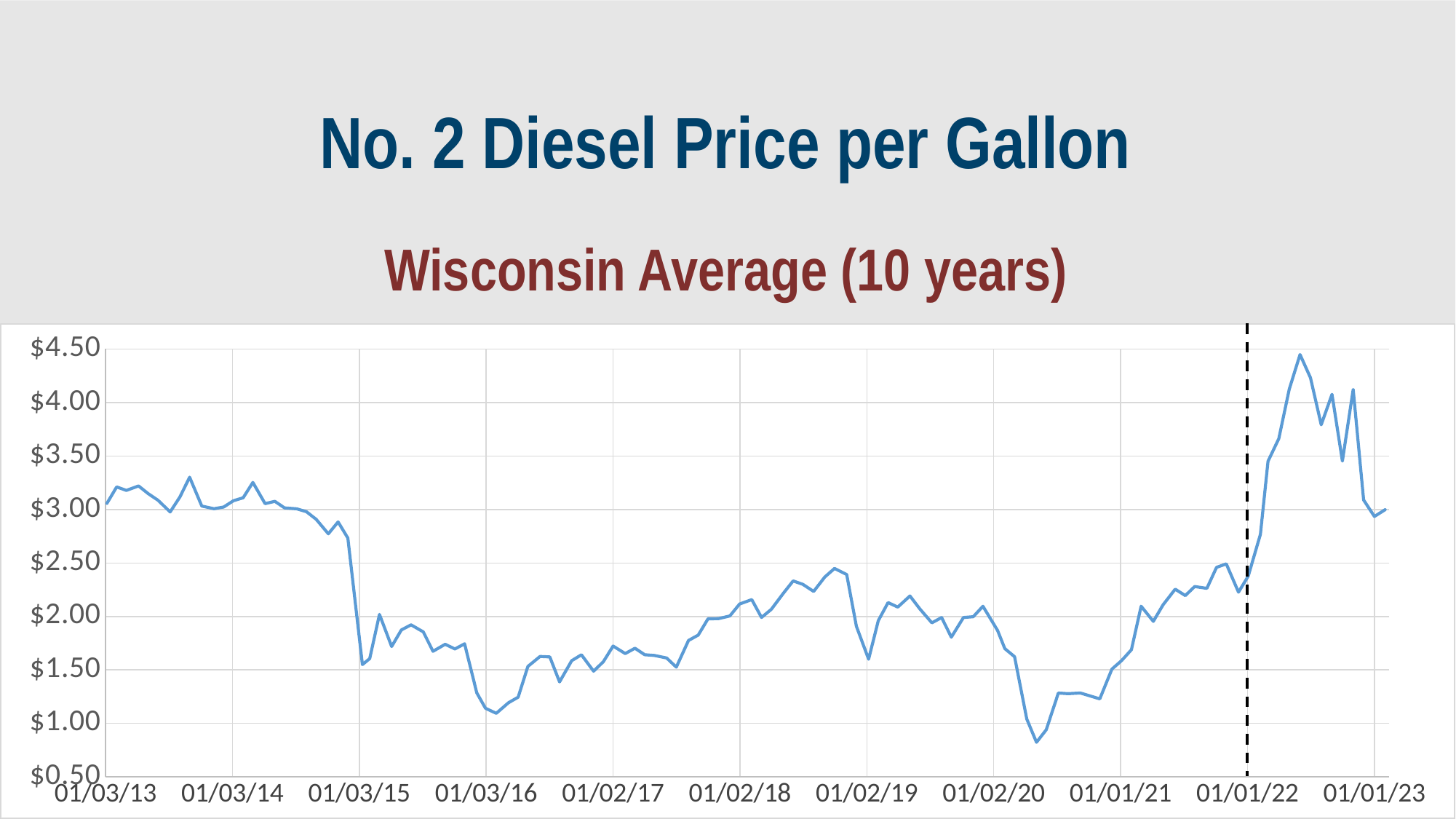
Which is larger, the value at 01/03/13 or the value at 01/03/16? 01/03/13 Does the line rise or fall between 01/01/21 and 01/01/22? rise Is the value at 01/01/23 greater or less than $2.50? greater Is the value at 01/03/16 greater or less than $1.50? less How many date labels are shown along the x axis? 11 Is the value at 01/03/13 greater or less than $2.50? greater What subtitle appears below the chart title? Wisconsin Average (10 years) What kind of chart is shown on the slide? line chart What is the title of the chart on the slide? No. 2 Diesel Price per Gallon In which year does the line reach its highest point? 2022